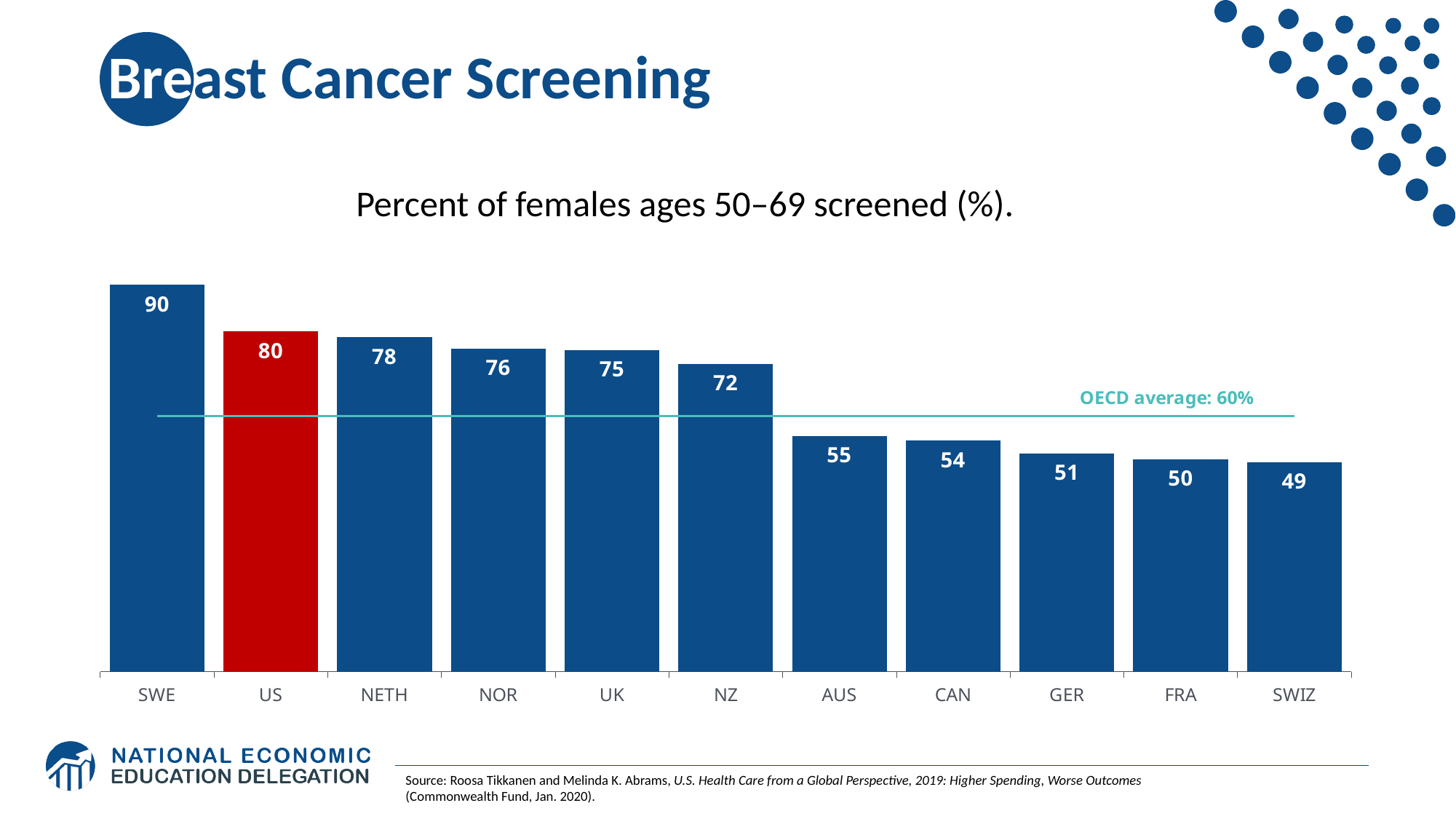
Which country has the lowest value? SWIZ What OECD average is marked by the horizontal line on the chart? 60% Which country has the highest value? SWE How many countries are shown on the chart? 11 What is the value for the US? 80 Which is larger, the value for NOR or the value for CAN? NOR What kind of chart is this? Bar chart What is the difference between the values for SWE and the US? 10 Do the values rise or fall from left to right along the x axis? Fall What is the difference between the values for NETH and AUS? 23 What is the value for NZ? 72 What is the value for FRA? 50